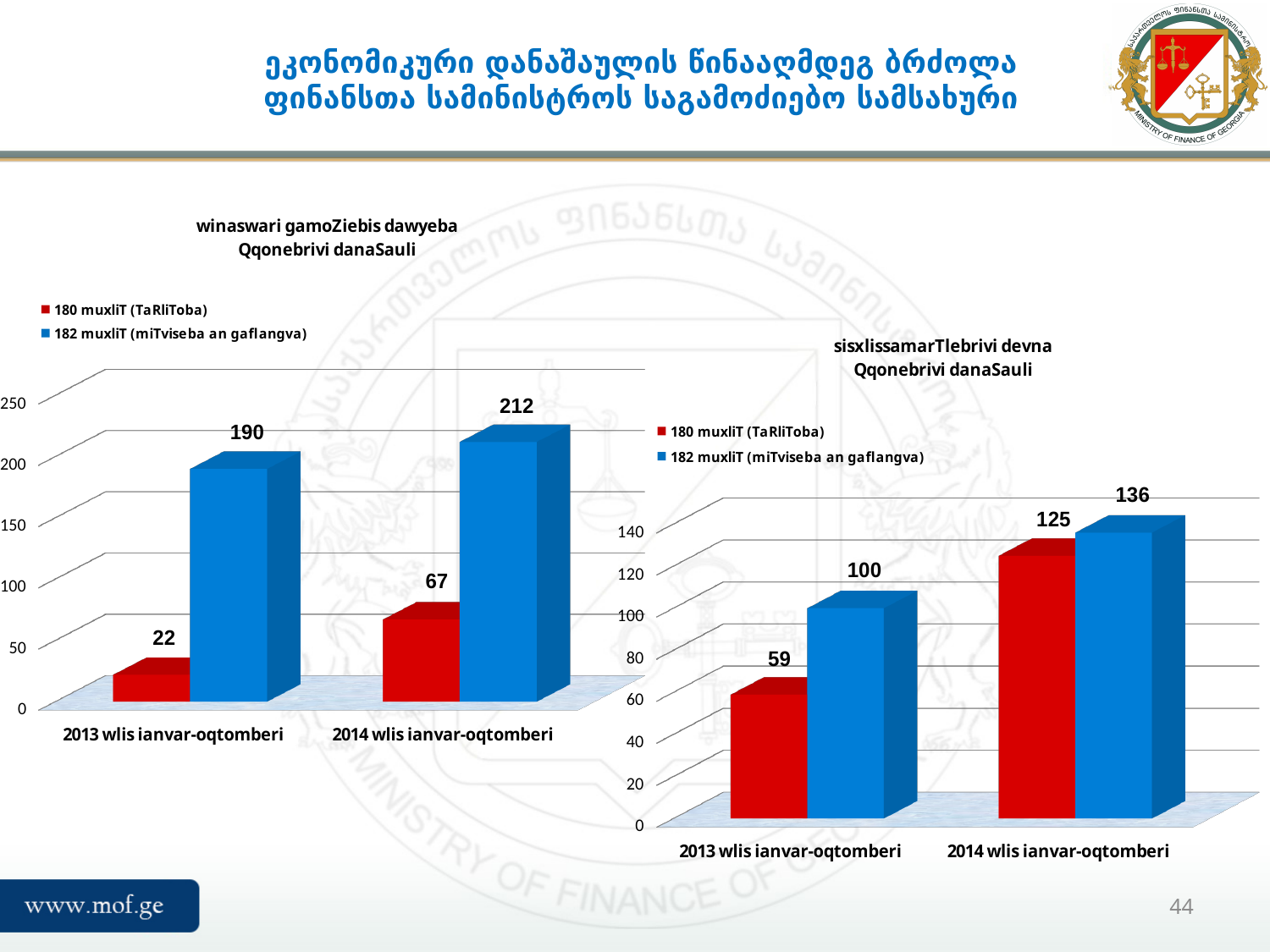
In the left chart (winaswari gamoZiebis dawyeba), what is the value for 182 muxliT (miTviseba an gaflangva) in 2013 wlis ianvar-oqtomberi? 190 In the right chart (sisxlissamarTlebrivi devna), which bar has the lowest value? 180 muxliT (TaRliToba) in 2013 wlis ianvar-oqtomberi In the right chart (sisxlissamarTlebrivi devna), what is the difference between the 180 muxliT values for 2014 and 2013? 66 In the left chart (winaswari gamoZiebis dawyeba), does the 180 muxliT (TaRliToba) value rise or fall from 2013 to 2014? Rise In the left chart (winaswari gamoZiebis dawyeba), what is the value for 180 muxliT (TaRliToba) in 2014 wlis ianvar-oqtomberi? 67 In the right chart (sisxlissamarTlebrivi devna), which is larger in 2014 wlis ianvar-oqtomberi: 180 muxliT or 182 muxliT? 182 muxliT (miTviseba an gaflangva) How many series does the legend of the left chart (winaswari gamoZiebis dawyeba) list? 2 In the right chart (sisxlissamarTlebrivi devna), what is the value for 182 muxliT (miTviseba an gaflangva) in 2014 wlis ianvar-oqtomberi? 136 In the right chart (sisxlissamarTlebrivi devna), what is the value for 180 muxliT (TaRliToba) in 2013 wlis ianvar-oqtomberi? 59 In the left chart (winaswari gamoZiebis dawyeba), what is the difference between the 182 muxliT values for 2014 and 2013? 22 In the left chart (winaswari gamoZiebis dawyeba), which series has the highest value overall? 182 muxliT (miTviseba an gaflangva) What kind of chart is the right chart (sisxlissamarTlebrivi devna)? Bar chart